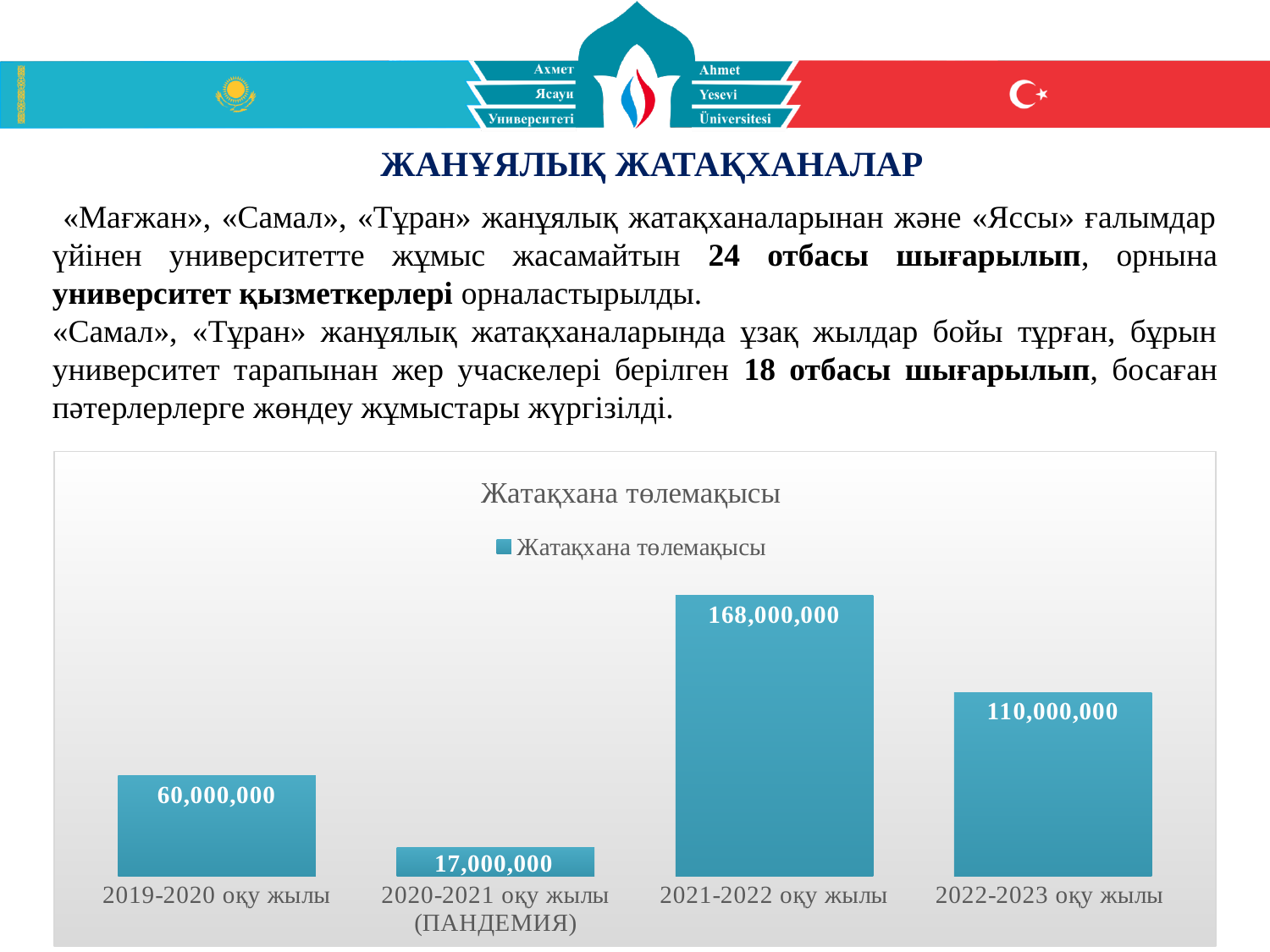
Which category has the highest value? 2021-2022 оқу жылы How many categories are shown on the x axis? 4 What is the value for 2022-2023 оқу жылы? 110,000,000 Which is larger, the value for 2019-2020 оқу жылы or 2022-2023 оқу жылы? 2022-2023 оқу жылы What is the value for 2020-2021 оқу жылы (ПАНДЕМИЯ)? 17,000,000 What is the value for 2019-2020 оқу жылы? 60,000,000 Which category has the lowest value? 2020-2021 оқу жылы (ПАНДЕМИЯ) What is the title of the chart? Жатақхана төлемақысы What is the value for 2021-2022 оқу жылы? 168,000,000 What is the difference between the values for 2021-2022 оқу жылы and 2022-2023 оқу жылы? 58,000,000 What kind of chart is shown on the slide? bar chart What is the difference between the values for 2019-2020 оқу жылы and 2020-2021 оқу жылы (ПАНДЕМИЯ)? 43,000,000